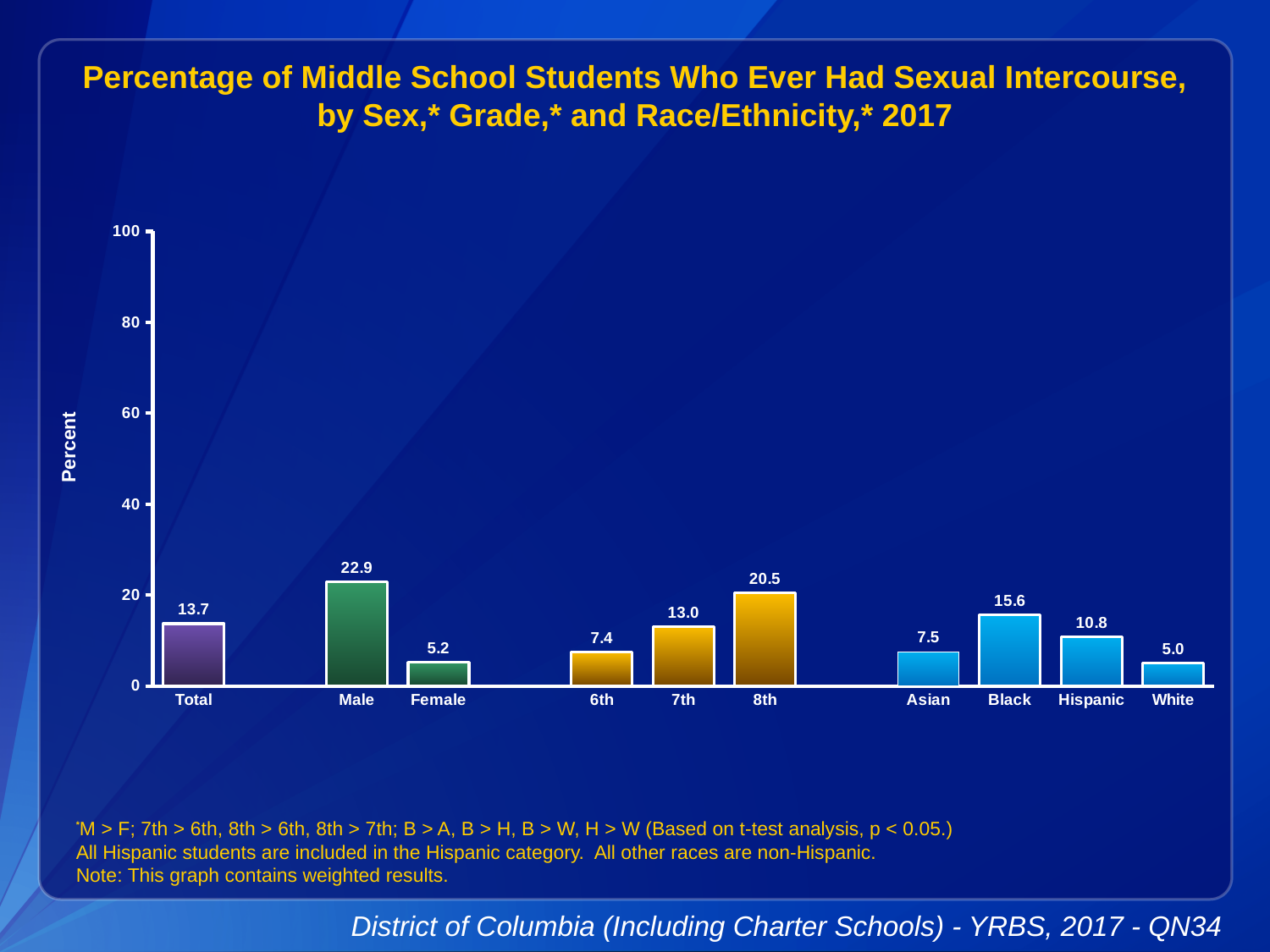
Is the value for 7th grade greater or less than 20? less What kind of chart is this? bar chart How many categories are shown on the x axis? 10 What is the difference between the 8th grade and 6th grade values? 13.1 What is the value for 8th grade? 20.5 Which is larger, the value for Black or the value for Hispanic? Black What is the difference between the Male and Female values? 17.7 What is the value for Total? 13.7 What is the value for Male? 22.9 What is the value for Hispanic students? 10.8 Which category has the highest value? Male Which category has the lowest value? White